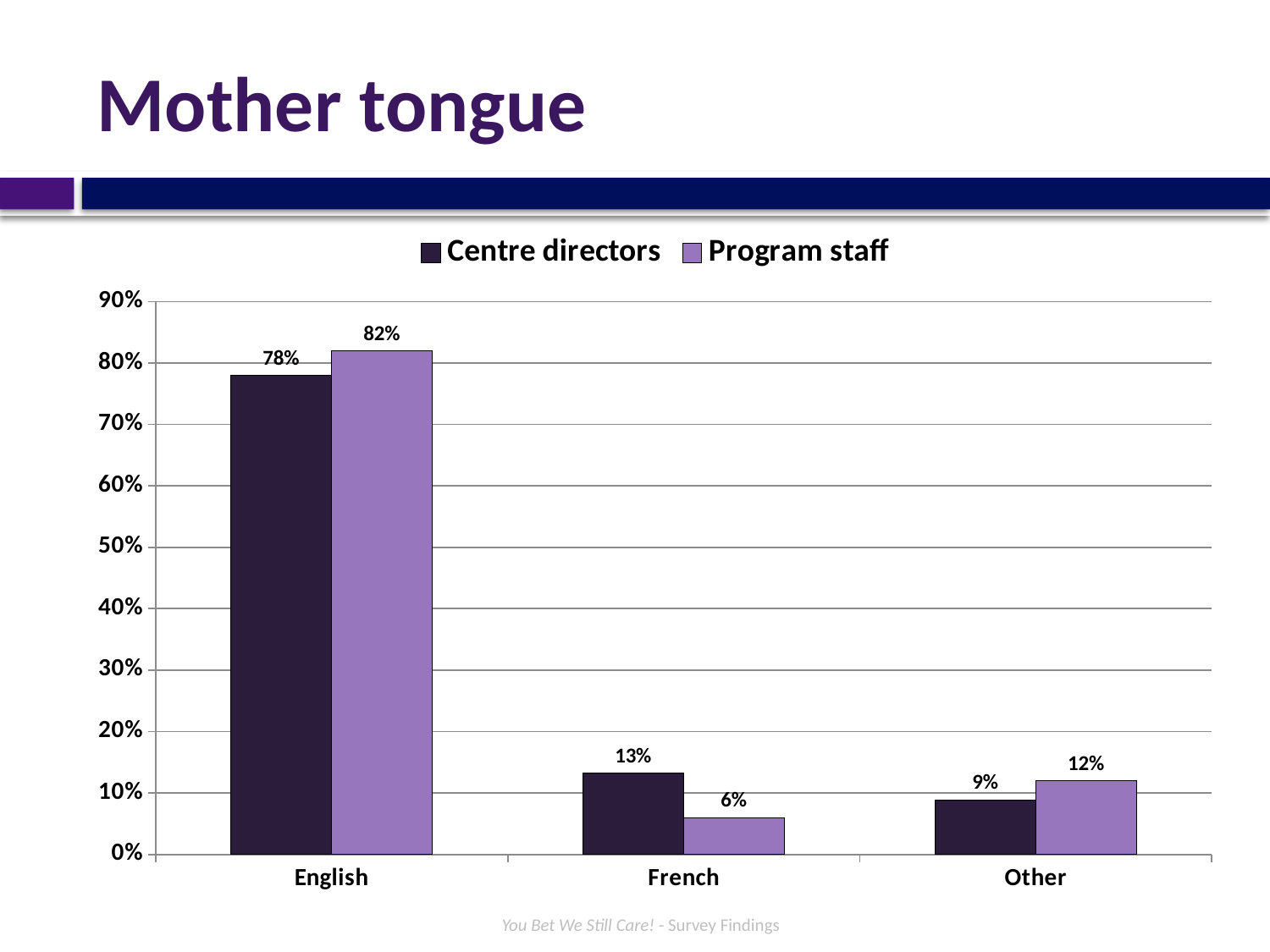
What percentage of Program staff have French as their mother tongue? 6% How many series does the legend list? 2 What is the difference between Program staff and Centre directors for English? 4% For the Other category, which group has the larger value, Centre directors or Program staff? Program staff Which mother tongue category has the highest value for Program staff? English Which mother tongue category has the lowest value for Centre directors? Other What percentage of Centre directors have English as their mother tongue? 78% What kind of chart is shown on the slide? Bar chart How many mother tongue categories are shown on the x axis? 3 What is the difference between Centre directors and Program staff for French? 7% What is the value for Program staff in the Other category? 12% Is the value for Centre directors in the French category greater or less than 10%? greater